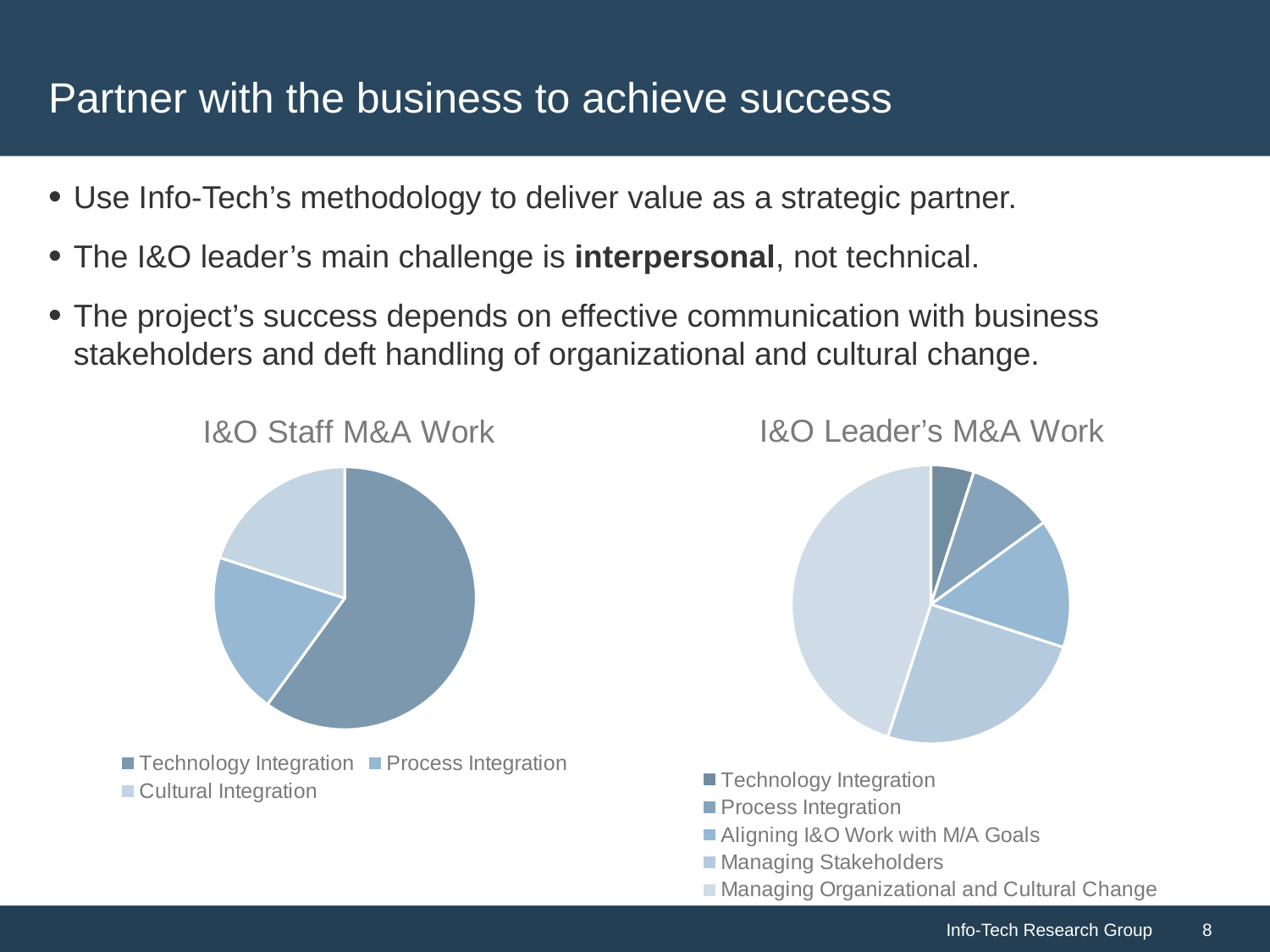
In the "I&O Staff M&A Work" chart, which is larger: Technology Integration or Cultural Integration? Technology Integration In the "I&O Leader's M&A Work" chart, which category has the largest slice? Managing Organizational and Cultural Change How many entries does the legend of the "I&O Leader's M&A Work" chart list? 5 What kind of chart is the "I&O Staff M&A Work" chart? Pie chart In the "I&O Leader's M&A Work" chart, which category has the smallest slice? Technology Integration What is the title of the pie chart on the left side of the slide? I&O Staff M&A Work What kind of chart is the "I&O Leader's M&A Work" chart? Pie chart In the "I&O Leader's M&A Work" chart, how many slices does the pie have? 5 In the "I&O Staff M&A Work" chart, how many slices does the pie have? 3 In the "I&O Leader's M&A Work" chart, which is larger: Managing Stakeholders or Process Integration? Managing Stakeholders In the "I&O Leader's M&A Work" chart, which is larger: Aligning I&O Work with M/A Goals or Technology Integration? Aligning I&O Work with M/A Goals In the "I&O Staff M&A Work" chart, which category has the largest slice? Technology Integration